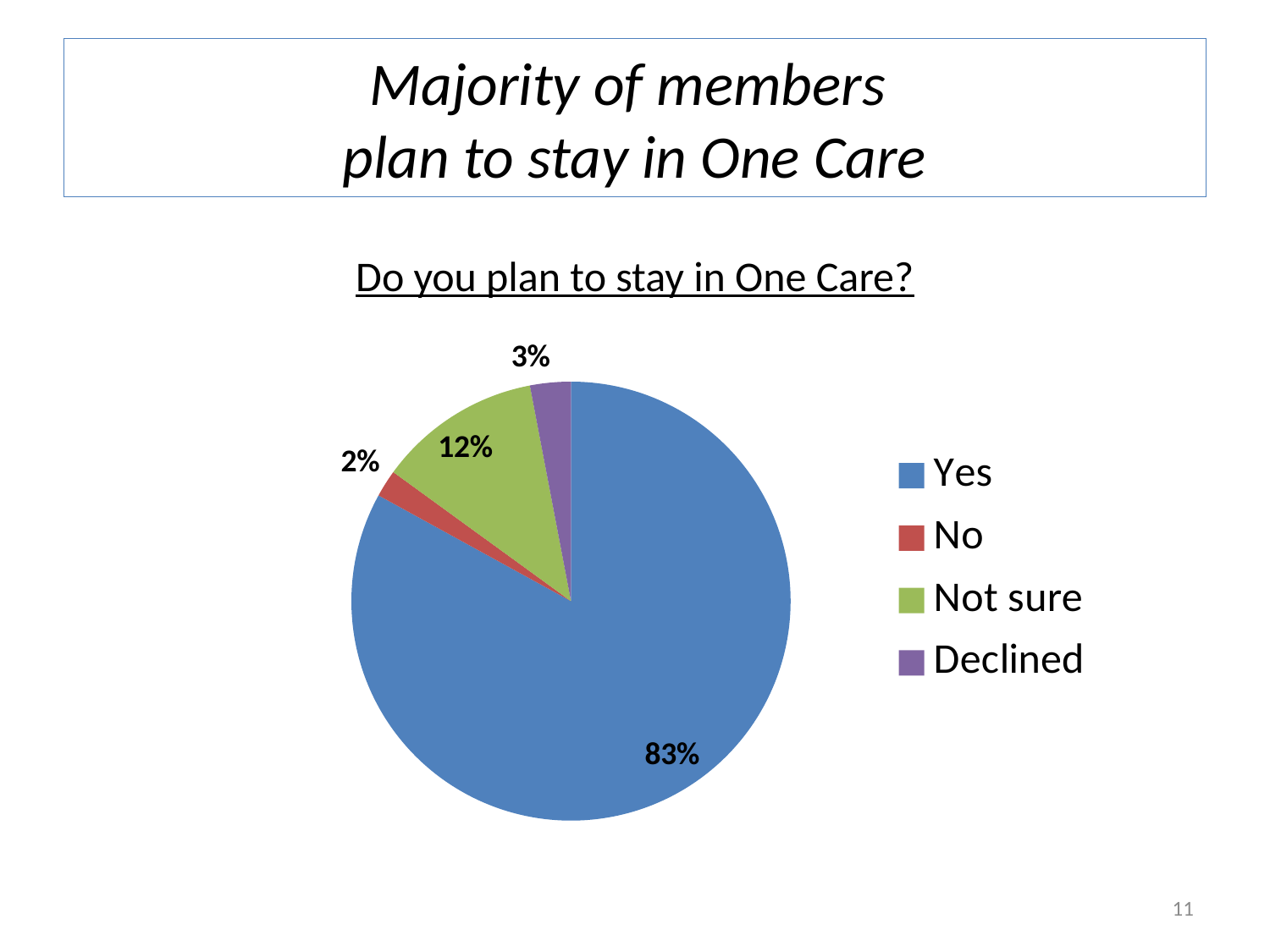
What kind of chart is shown on the slide? Pie chart Which response has the smallest slice of the pie? No How many response categories does the pie chart show? 4 What question is the pie chart answering, as written above the chart? Do you plan to stay in One Care? Which is larger, the share for "Not sure" or the share for "Declined"? Not sure What colour is the "Not sure" slice in the pie chart? Green What share of members answered "No"? 2% What share of members answered "Yes" to "Do you plan to stay in One Care?" 83% What share of members answered "Not sure"? 12% What is the difference in percentage points between the "Yes" share and the "Not sure" share? 71 percentage points Which response has the largest slice of the pie? Yes